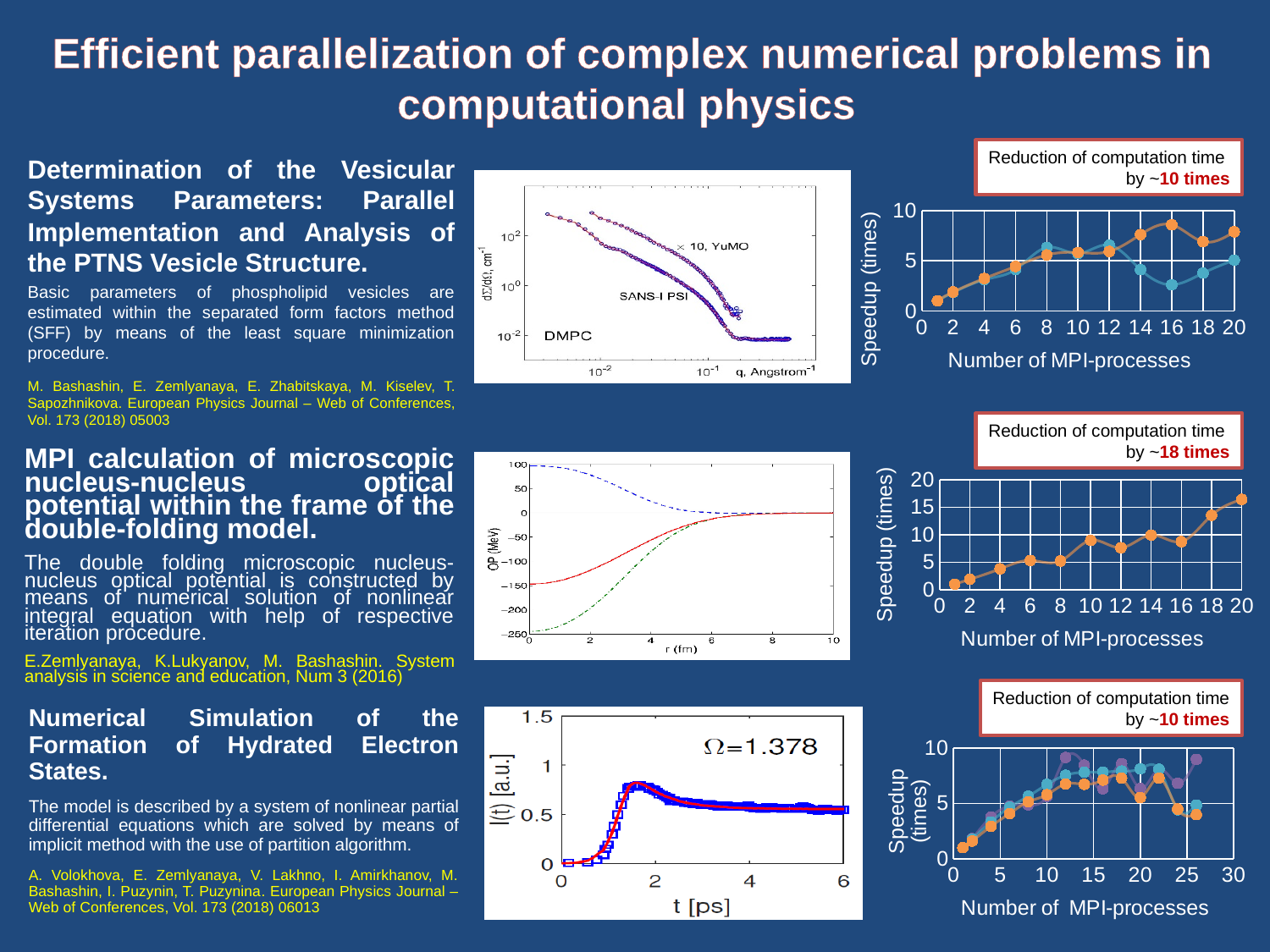
What kind of chart is the middle chart on the right (Reduction of computation time by ~18 times)? line chart In the top chart on the right (~10 times), is the blue series value at 16 MPI-processes greater or less than 5? less In the middle chart on the right (~18 times), at which number of MPI-processes is the speedup highest? 20 In the middle chart on the right (~18 times), is the speedup at 2 MPI-processes greater or less than 5? less In the middle chart on the right (~18 times), does the speedup generally rise or fall as the number of MPI-processes increases? rise What is the x-axis label of the top chart on the right? Number of MPI-processes In the top chart on the right (~10 times), is the speedup at 2 MPI-processes greater or less than 5? less What is the highest tick value on the y-axis of the middle chart on the right? 20